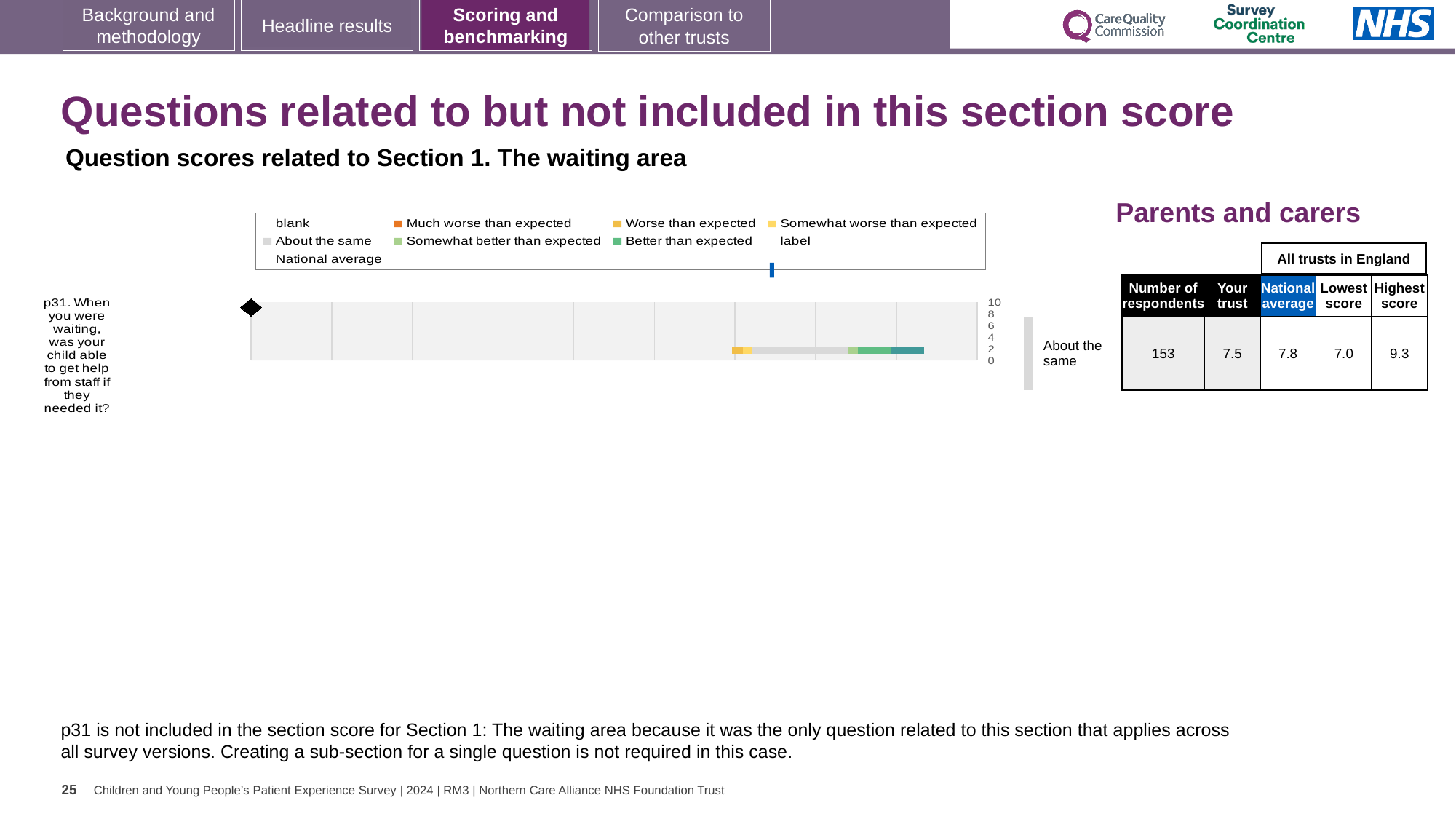
What is the lowest score among all trusts in England for p31? 7.0 What benchmark category label is shown to the right of the p31 bar? About the same Which is larger for p31, the 'Your trust' score or the national average? National average How many questions are plotted in the chart? 1 How many respondents answered p31? 153 What kind of chart is used to show the p31 question score? bar chart What is the 'Your trust' score for p31? 7.5 What is the national average score for p31? 7.8 What is the highest score among all trusts in England for p31? 9.3 Is the 'Your trust' score for p31 greater or less than 8? less Which question number is plotted in the chart? p31 What is the difference between the highest score and the lowest score for p31? 2.3